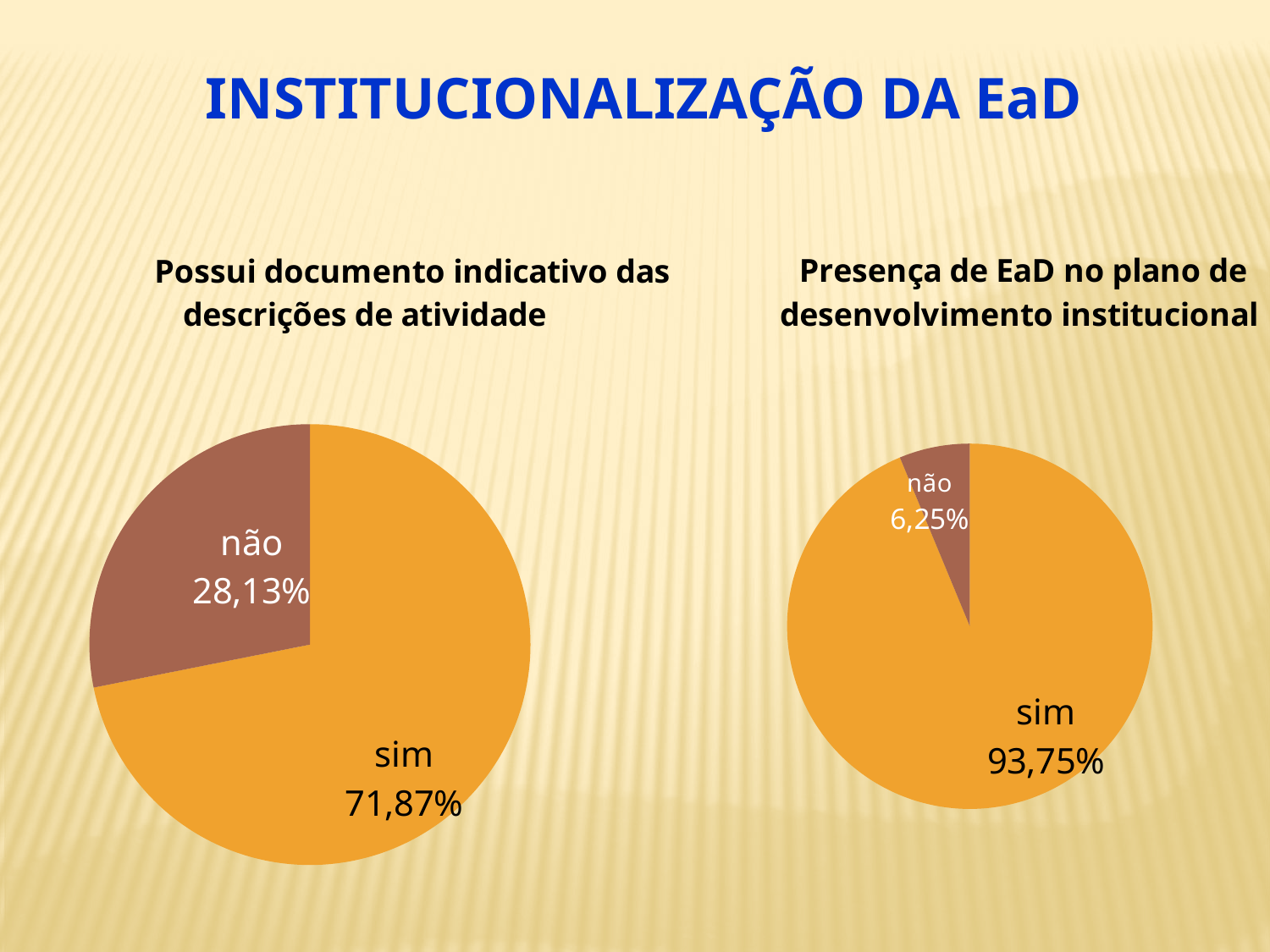
In the right chart 'Presença de EaD no plano de desenvolvimento institucional', which slice is the smallest? não Which chart has the larger 'não' slice, the left chart or the right chart? the left chart What type of chart is the left chart 'Possui documento indicativo das descrições de atividade'? pie chart In the right chart 'Presença de EaD no plano de desenvolvimento institucional', what is the value for 'não'? 6,25% In the right chart 'Presença de EaD no plano de desenvolvimento institucional', what is the difference between the 'sim' and 'não' values? 87,50% In the left chart 'Possui documento indicativo das descrições de atividade', what is the value for 'não'? 28,13% In the left chart 'Possui documento indicativo das descrições de atividade', what is the value for 'sim'? 71,87% What is the title of the slide? INSTITUCIONALIZAÇÃO DA EaD In the right chart 'Presença de EaD no plano de desenvolvimento institucional', what is the value for 'sim'? 93,75% How many slices does the right chart 'Presença de EaD no plano de desenvolvimento institucional' have? 2 In the left chart 'Possui documento indicativo das descrições de atividade', which slice is the largest? sim In the left chart 'Possui documento indicativo das descrições de atividade', what is the difference between the 'sim' and 'não' values? 43,74%